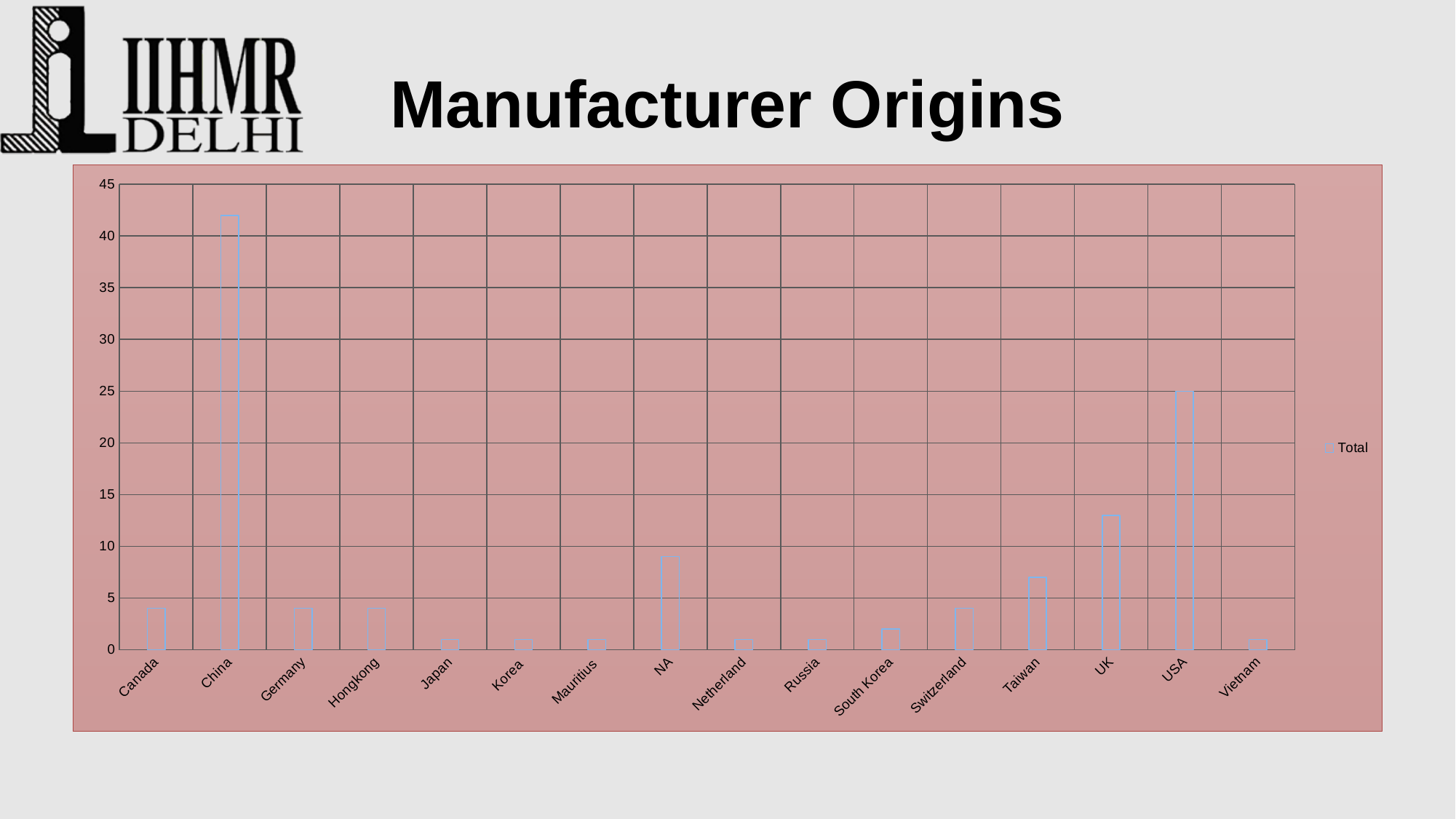
What type of chart is shown on the slide? bar chart How many categories are shown on the x axis? 16 What is the name of the series shown in the legend? Total Which has a larger value, Taiwan or Canada? Taiwan Is the value for China greater or less than 40? greater Which has a larger value, USA or UK? USA Which country has the highest value in the chart? China Is the value for UK greater or less than 10? greater Is the value for NA greater or less than 10? less What is the value for USA? 25 How many series does the legend list? 1